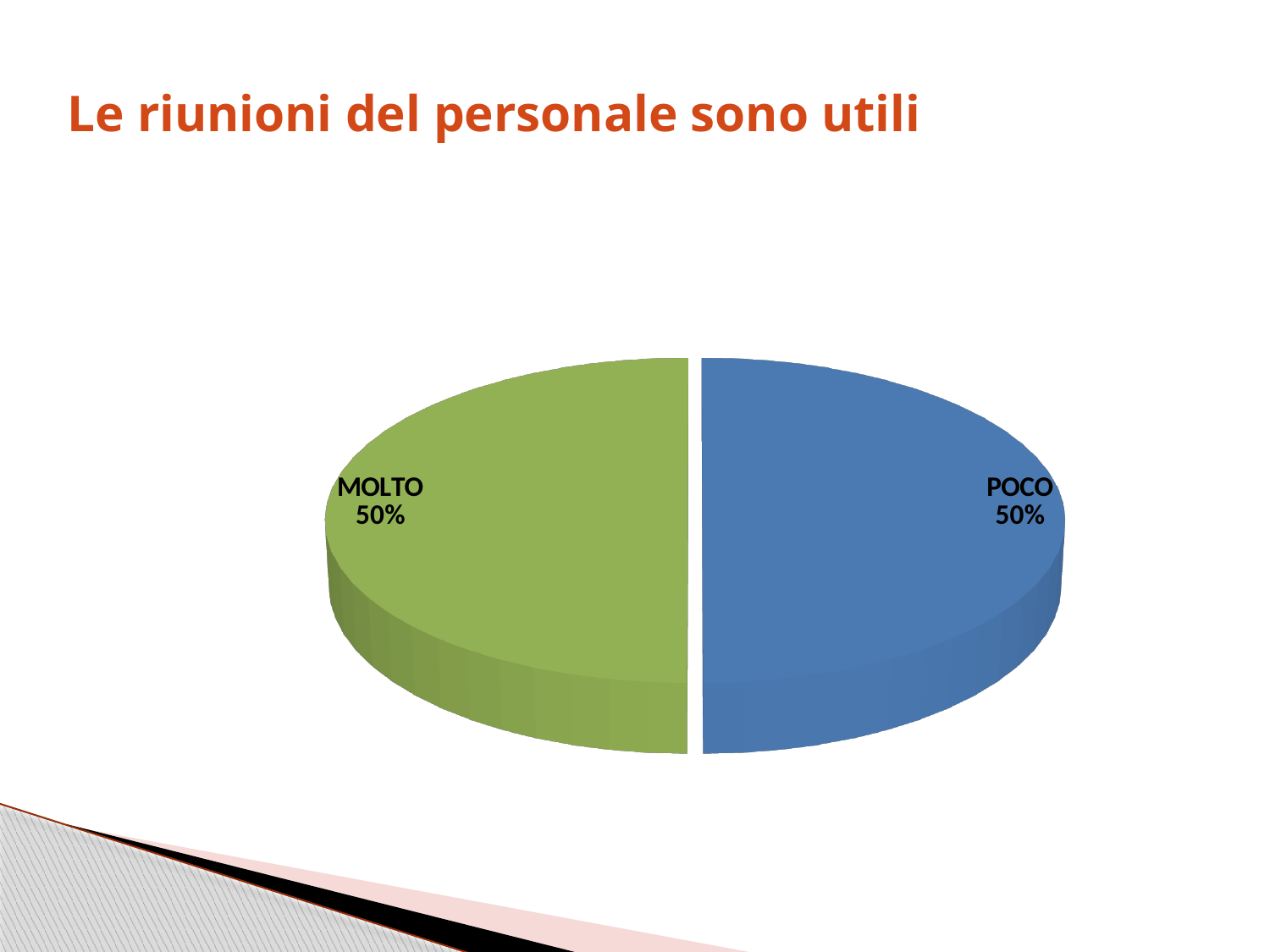
What share of the pie does the MOLTO slice represent? 50% What share of the pie does the POCO slice represent? 50% What is the combined share of the MOLTO and POCO slices? 100% How many slices does the pie chart have? 2 Is the share for POCO greater or less than 25%? greater What kind of chart is shown on the slide? pie chart What colour is the MOLTO slice? green What is the title of the slide containing the pie chart? Le riunioni del personale sono utili What is the difference between the MOLTO and POCO shares? 0%